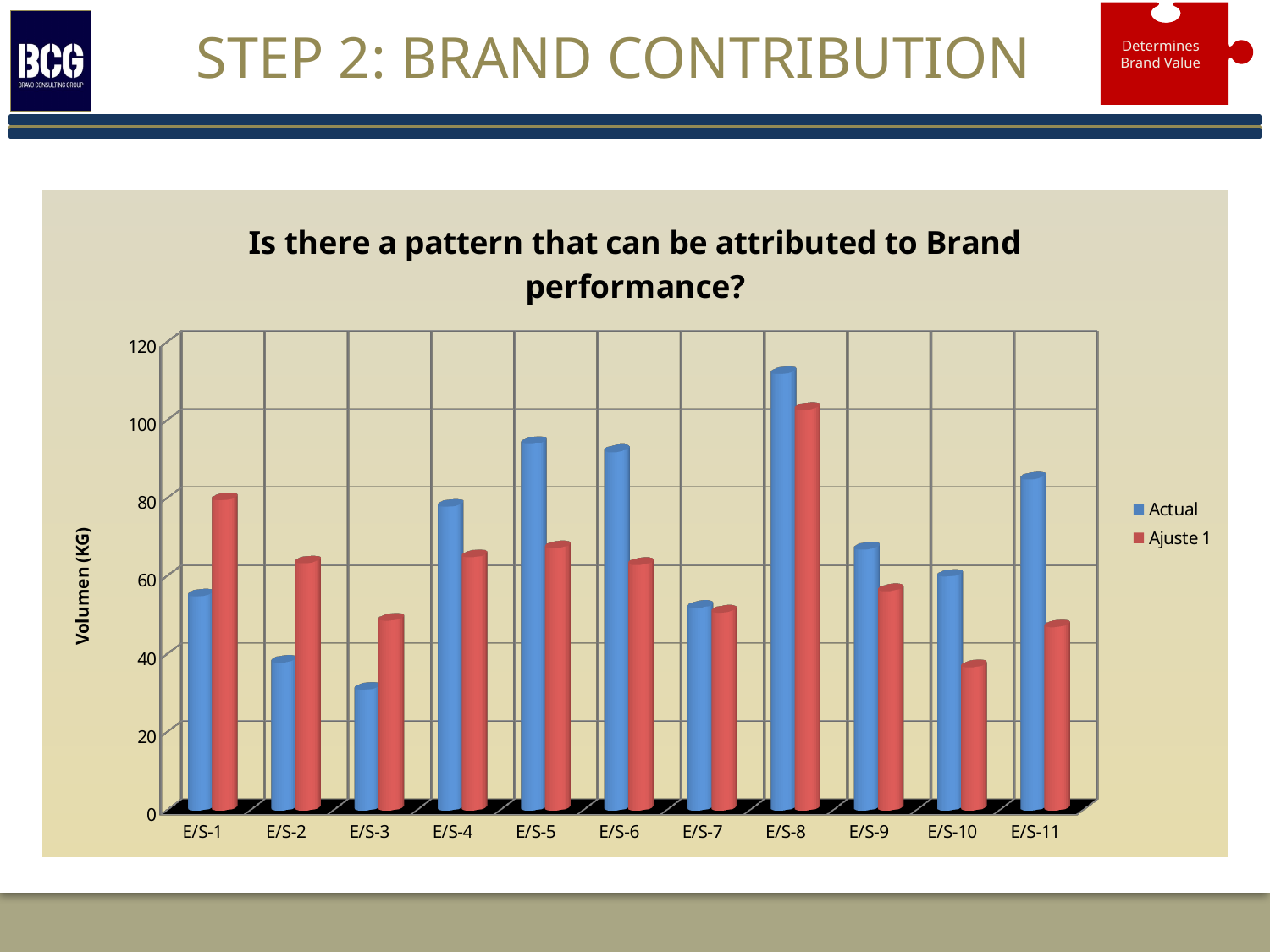
Which category has the lowest Actual value? E/S-3 Which category has the highest Actual value? E/S-8 What is the label on the vertical axis of the chart? Volumen (KG) How many categories are shown on the x axis? 11 Which category has the lowest Ajuste 1 value? E/S-10 For E/S-11, which is larger, the Actual value or the Ajuste 1 value? Actual Is the Ajuste 1 value for E/S-11 greater or less than 60? less How many series does the legend list? 2 Is the Actual value for E/S-8 greater or less than 100? greater For E/S-1, which is larger, the Actual value or the Ajuste 1 value? Ajuste 1 What kind of chart is shown on the slide? Bar chart Is the Actual value for E/S-3 greater or less than 40? less